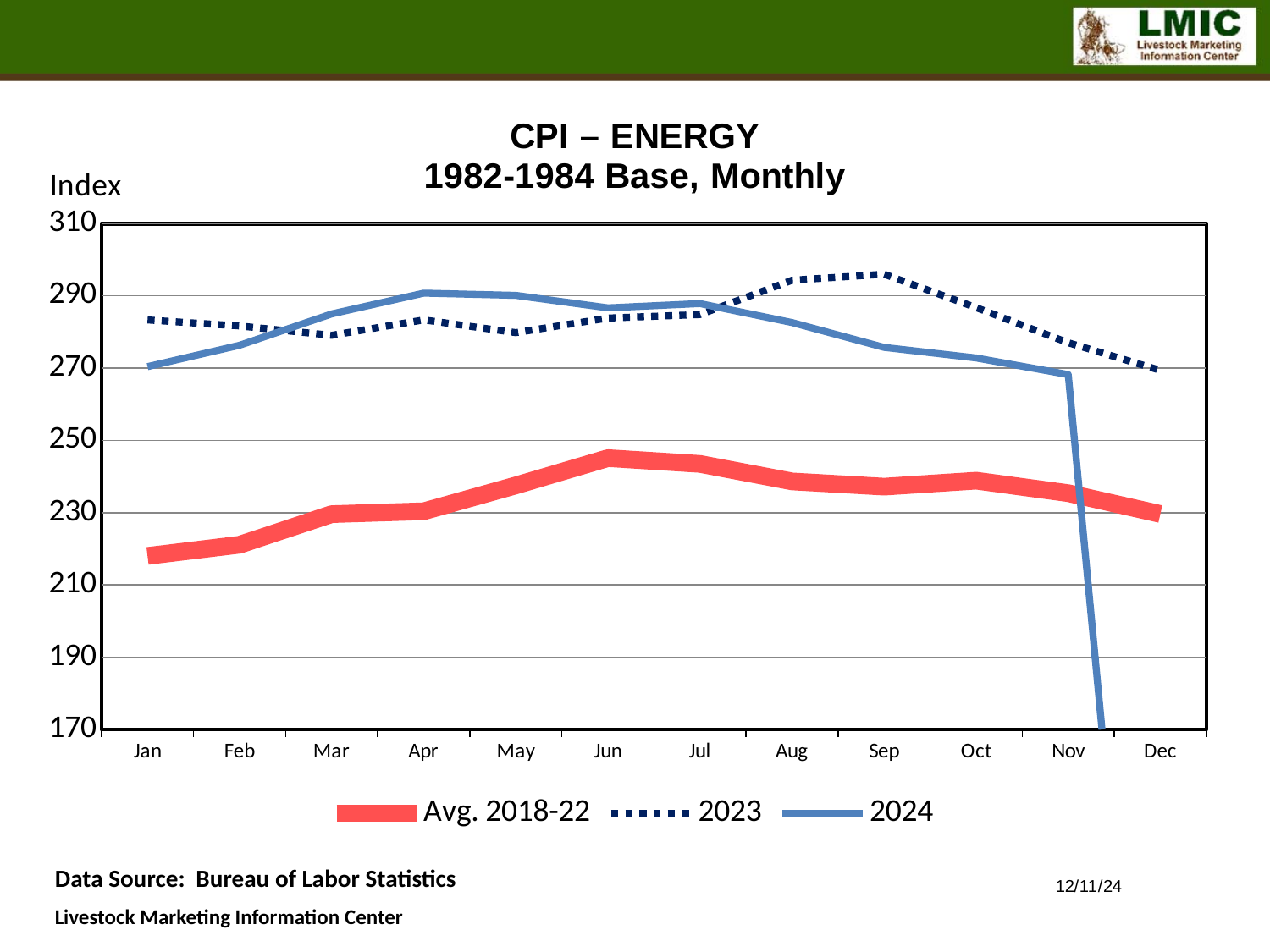
In which month is the 2023 series at its highest? Sep What kind of chart is shown on the slide? line chart How many months are shown on the x axis? 12 Is the value for Avg. 2018-22 in Jan greater or less than 230? less Which series is drawn with a dotted line? 2023 In which month is the Avg. 2018-22 series at its lowest? Jan How many series does the legend list? 3 In Sep, which series is higher, 2023 or 2024? 2023 What is the title of the chart? CPI – ENERGY 1982-1984 Base, Monthly In which month is the Avg. 2018-22 series at its highest? Jun Is the value for 2023 in Sep greater or less than 290? greater Does the Avg. 2018-22 series rise or fall from Jan to Jun? rise